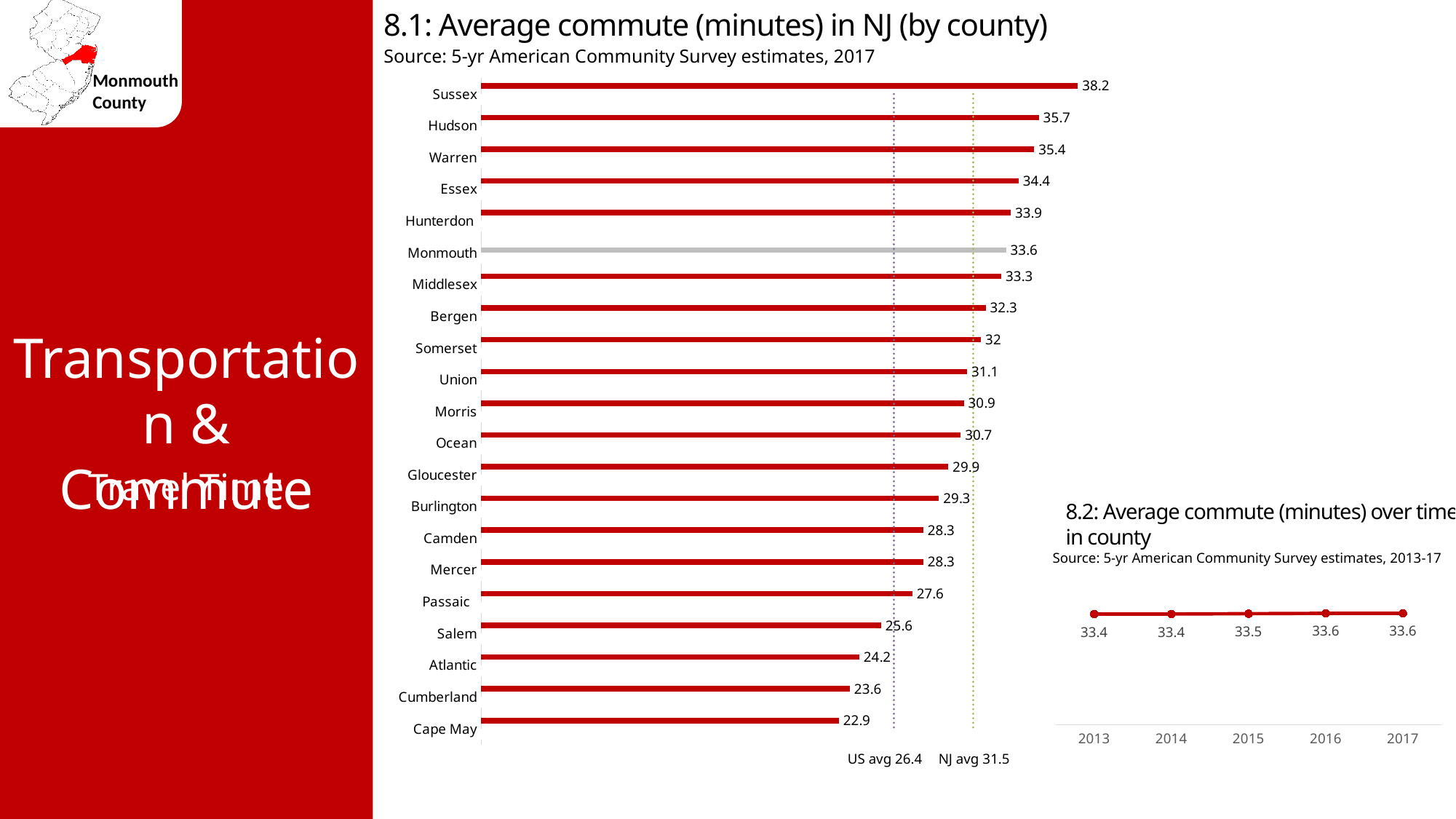
In chart 8.2 (Average commute over time in county), how many years are plotted? 5 In chart 8.1 (Average commute in NJ by county), what is the difference between the values for Sussex and Cape May? 15.3 What kind of chart is chart 8.1 (Average commute in NJ by county)? Bar chart In chart 8.1 (Average commute in NJ by county), which county has the highest average commute? Sussex In chart 8.1 (Average commute in NJ by county), which has a longer average commute, Hudson or Warren? Hudson In chart 8.1 (Average commute in NJ by county), which county has the lowest average commute? Cape May In chart 8.1 (Average commute in NJ by county), what NJ average is shown by the reference line? 31.5 In chart 8.1 (Average commute in NJ by county), what is the average commute for Monmouth? 33.6 In chart 8.1 (Average commute in NJ by county), what is the value for Passaic? 27.6 In chart 8.2 (Average commute over time in county), what is the value for 2015? 33.5 In chart 8.1 (Average commute in NJ by county), how many counties are shown? 21 In chart 8.2 (Average commute over time in county), do the values rise or fall from 2013 to 2017? Rise